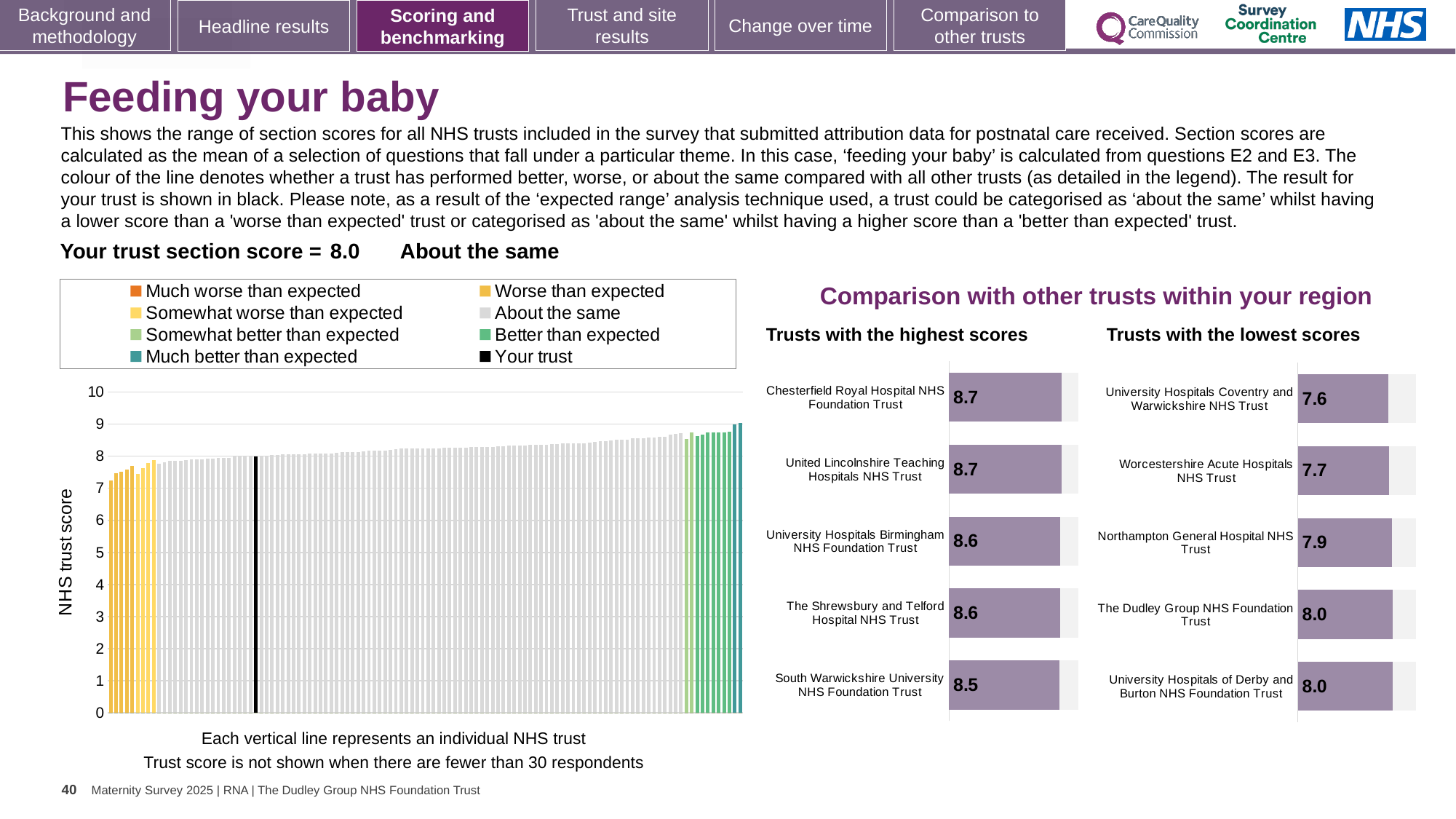
In the 'Trusts with the highest scores' chart, what is the score for Chesterfield Royal Hospital NHS Foundation Trust? 8.7 In the 'Trusts with the highest scores' chart, which trust has the lowest score? South Warwickshire University NHS Foundation Trust In the 'Trusts with the lowest scores' chart, which trust has the lowest score? University Hospitals Coventry and Warwickshire NHS Trust In the large 'NHS trust score' chart on the left, what kind of chart is it? Bar chart In the 'Trusts with the lowest scores' chart, what is the score for University Hospitals Coventry and Warwickshire NHS Trust? 7.6 In the 'Trusts with the highest scores' chart, what is the score for South Warwickshire University NHS Foundation Trust? 8.5 How many entries does the legend of the large 'NHS trust score' chart on the left list? 8 How many trusts are shown in the 'Trusts with the highest scores' chart? 5 In the 'Trusts with the lowest scores' chart, what is the difference between the scores of The Dudley Group NHS Foundation Trust and University Hospitals Coventry and Warwickshire NHS Trust? 0.4 In the 'Trusts with the lowest scores' chart, what is the score for Northampton General Hospital NHS Trust? 7.9 In the large 'NHS trust score' chart on the left, is the value for the black 'Your trust' bar greater or less than 5? greater In the 'Trusts with the lowest scores' chart, which has the higher score: Northampton General Hospital NHS Trust or Worcestershire Acute Hospitals NHS Trust? Northampton General Hospital NHS Trust